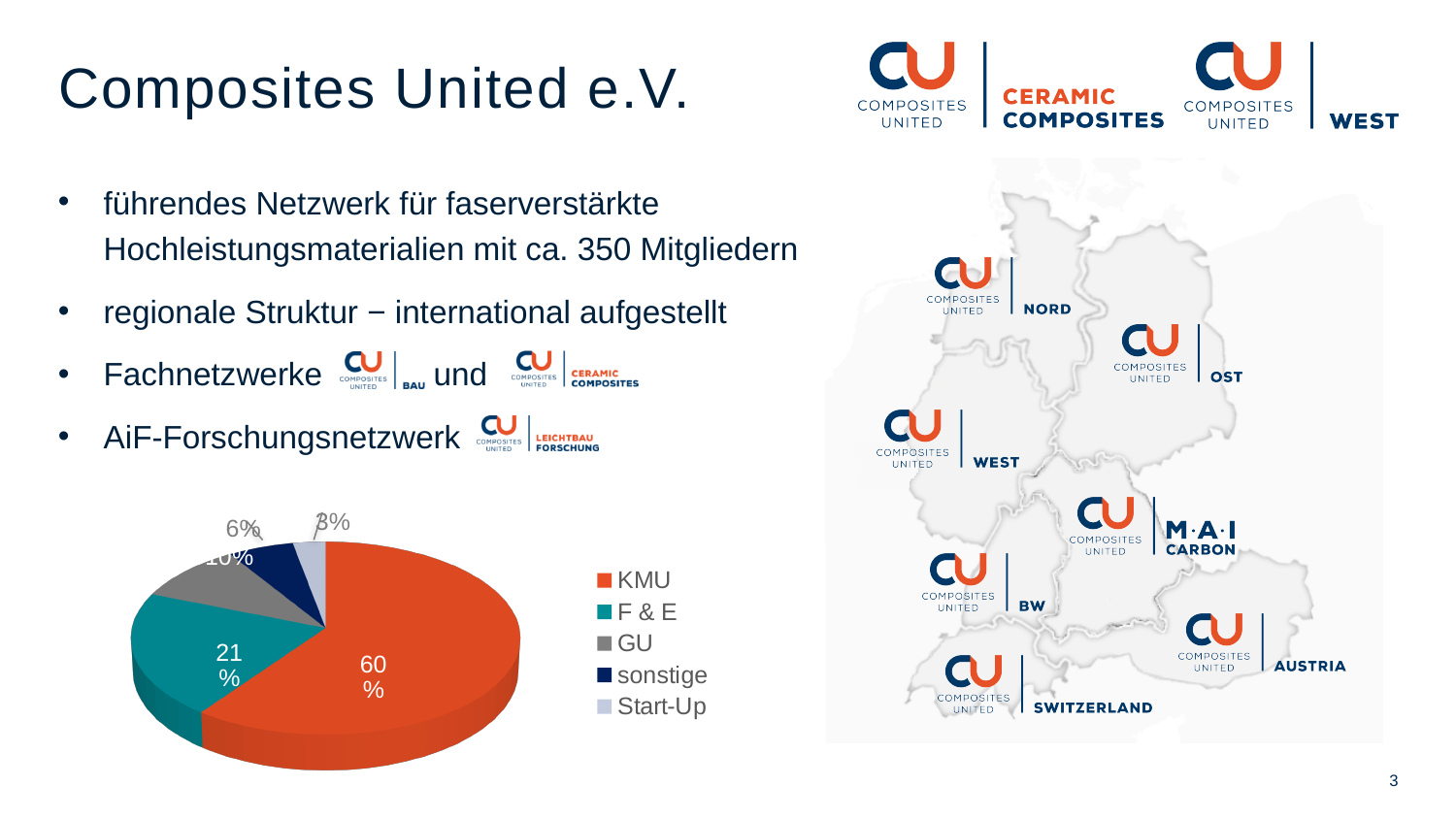
What is the difference between the F & E share and the sonstige share in the pie chart? 15% What is the value shown for F & E in the pie chart? 21% What share of the pie does KMU have? 60% Which category has the largest slice of the pie chart? KMU What is the difference between the KMU share and the F & E share in the pie chart? 39% What kind of chart is shown on the slide? pie chart Which category has the smallest slice of the pie chart? Start-Up What is the value shown for Start-Up in the pie chart? 3% What is the value shown for sonstige in the pie chart? 6% Which is larger in the pie chart, KMU or F & E? KMU Which legend entry is shown in red in the pie chart? KMU How many categories does the pie chart's legend list? 5